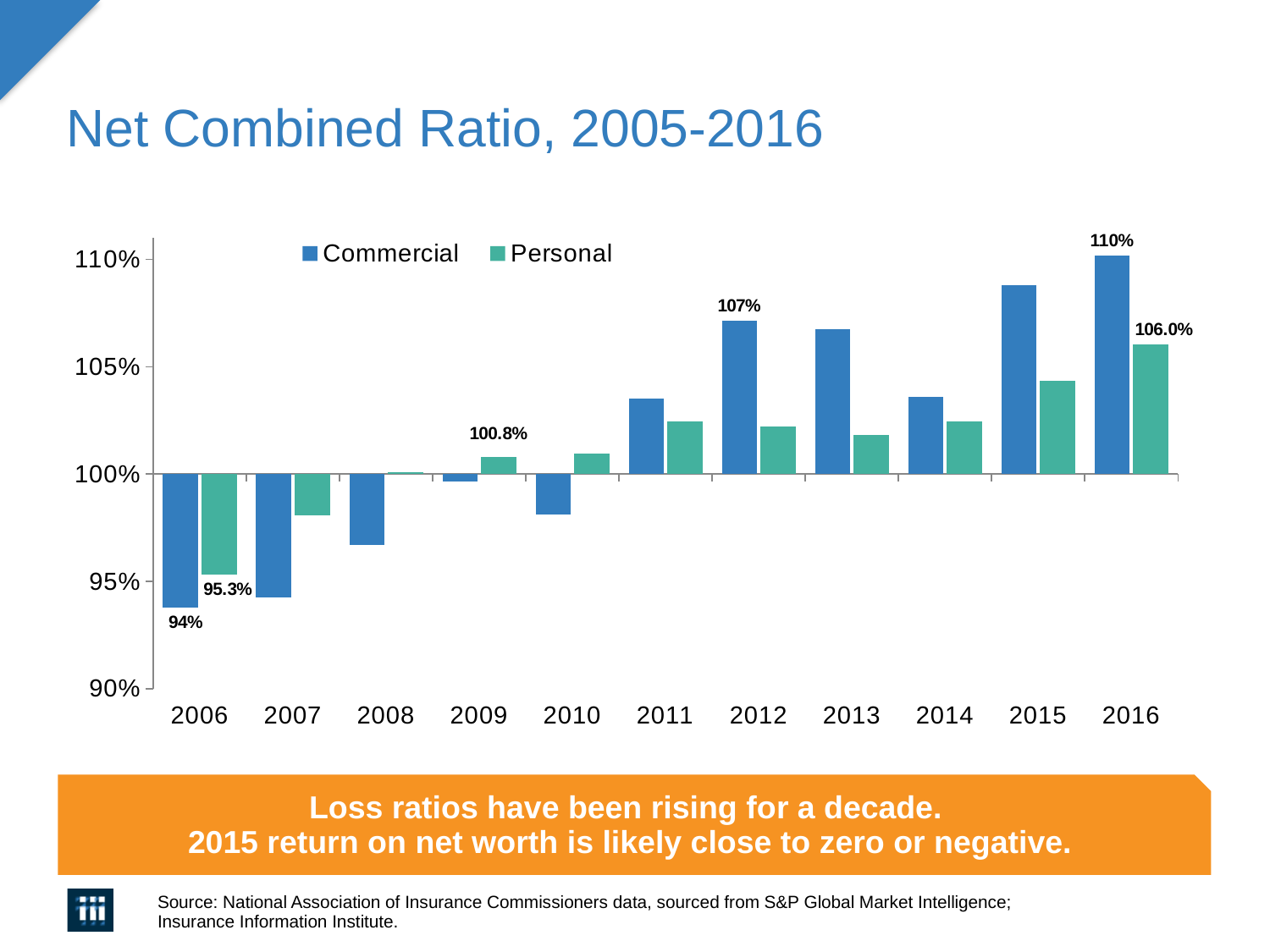
In which year is the Commercial net combined ratio highest? 2016 What is the Personal net combined ratio for 2016? 106.0% In which year is the Commercial net combined ratio lowest? 2006 How many series does the legend list? 2 What is the Commercial net combined ratio for 2012? 107% How many years are shown on the x axis of the chart? 11 What is the Personal net combined ratio for 2009? 100.8% Is the Commercial value for 2010 greater or less than 100%? less What is the Commercial net combined ratio for 2006? 94% In 2016, which is larger, the Commercial or the Personal net combined ratio? Commercial What is the Personal net combined ratio for 2006? 95.3% What is the Commercial net combined ratio for 2016? 110%